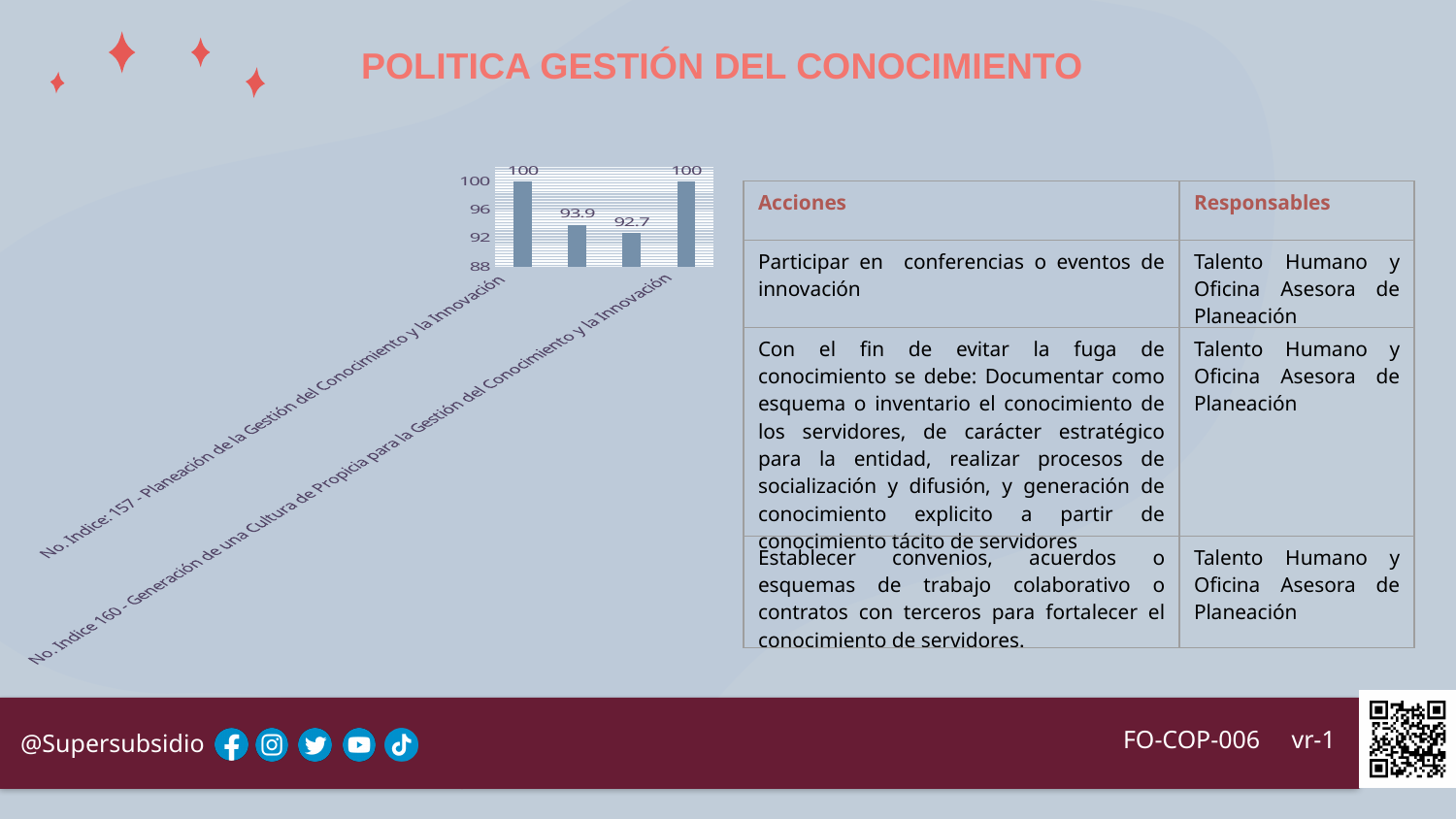
What is the highest tick value shown on the vertical axis of the chart? 100 What is the value shown on the first (leftmost) bar of the chart? 100 Which is larger, the second bar or the third bar? the second bar (93.9) What is the difference between the first bar (100) and the third bar (92.7)? 7.3 Which bar has the lowest value in the chart? the third bar (92.7) What is the value shown on the last (rightmost) bar of the chart? 100 What is the value shown on the second bar of the chart? 93.9 What kind of chart is shown on the slide? bar chart What is the difference between the second bar (93.9) and the third bar (92.7)? 1.2 How many bars are plotted in the chart? 4 Is the value of the third bar greater or less than 96? less What is the value shown on the third bar of the chart? 92.7